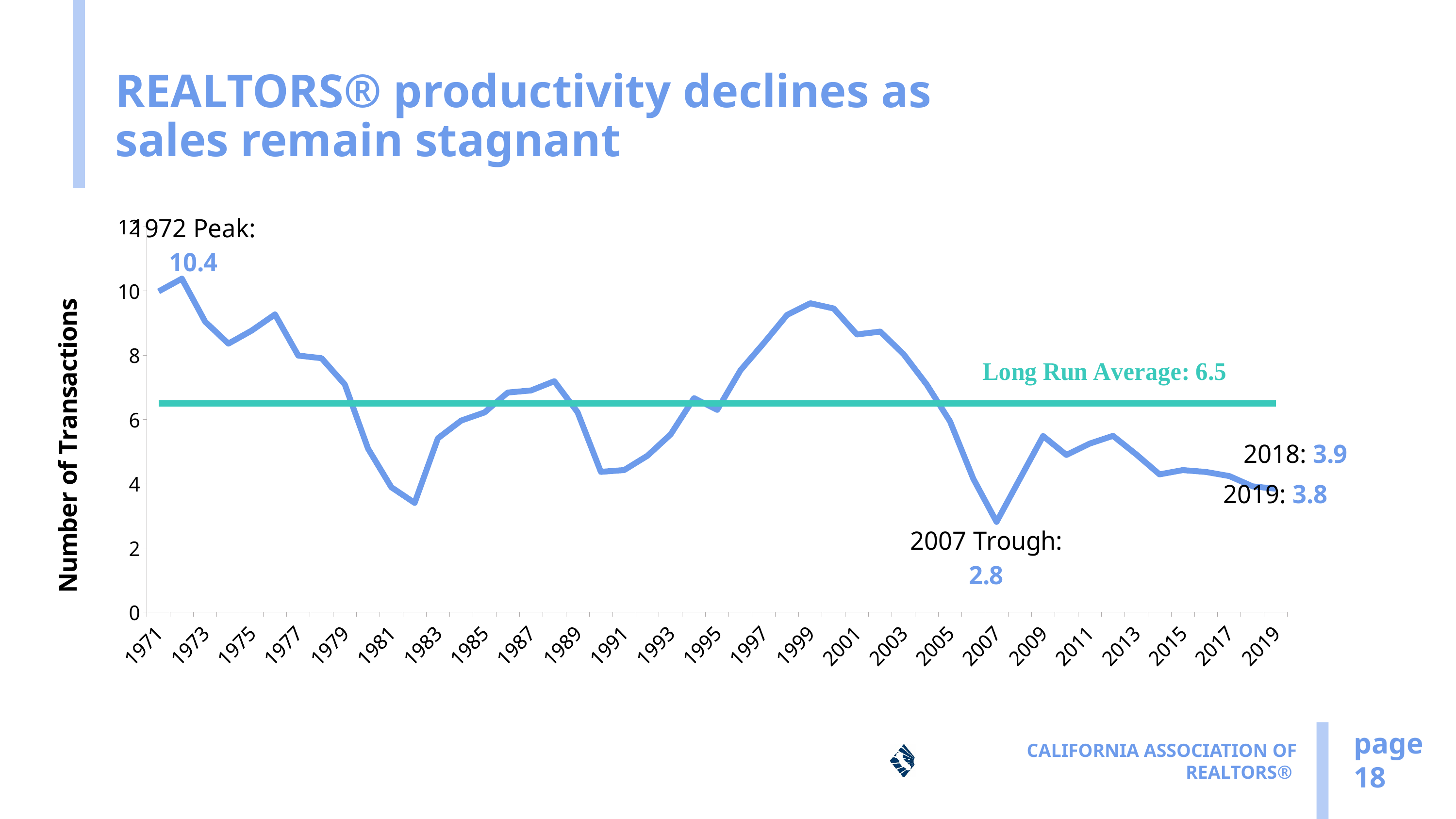
What was the number of transactions at the 1972 peak? 10.4 What is the long run average number of transactions shown on the chart? 6.5 What kind of chart is shown on the slide? line chart In which year did the number of transactions hit its trough? 2007 Is the value for 1999 greater or less than 8? greater What is the label on the vertical axis? Number of Transactions What is the number of transactions for 2018? 3.9 What is the number of transactions for 2019? 3.8 In which year did the number of transactions reach its peak? 1972 What was the number of transactions at the 2007 trough? 2.8 What is the difference between the 1972 peak and the 2007 trough? 7.6 Which year had more transactions, 2018 or 2019? 2018